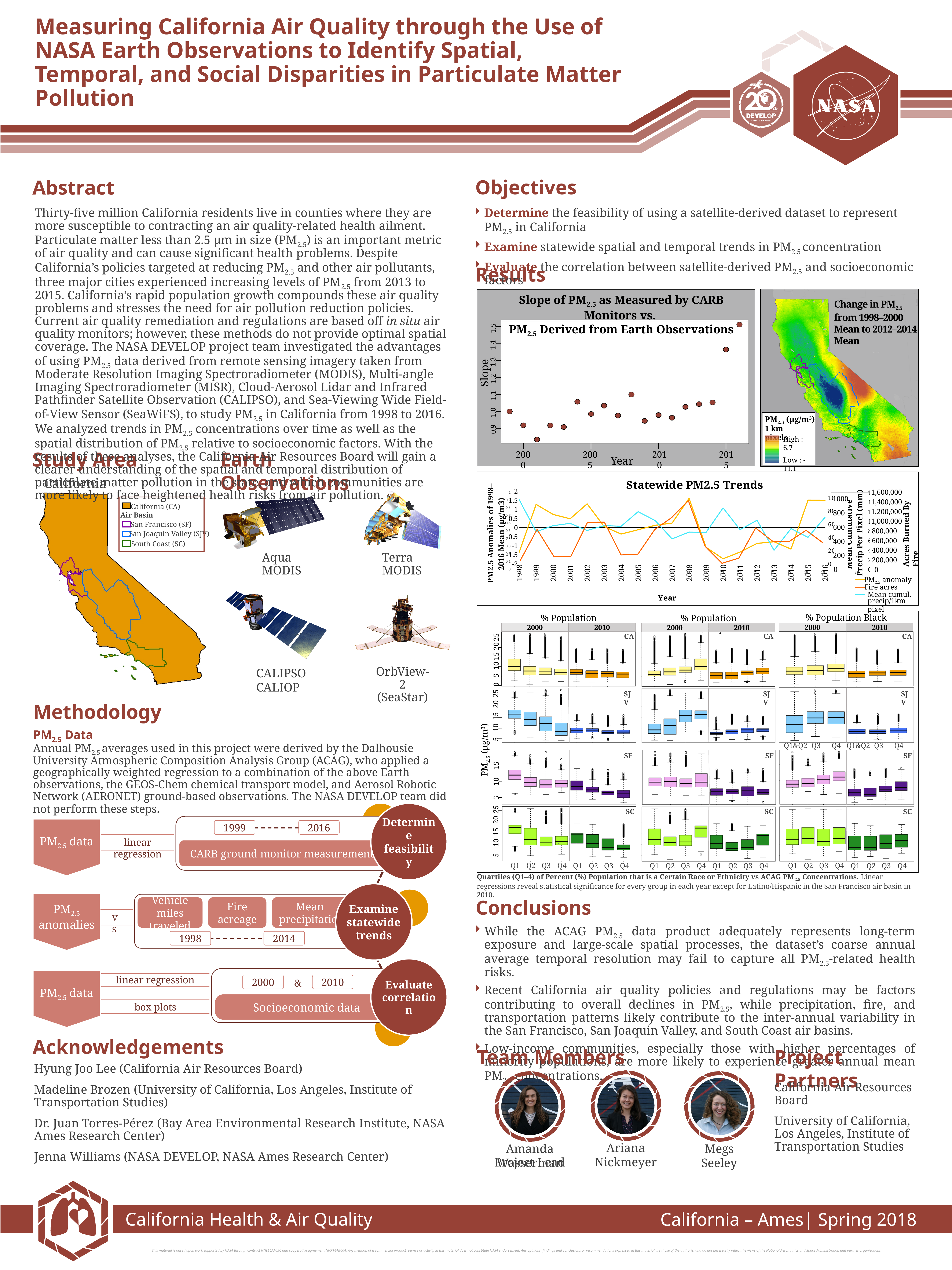
How many quartile groups (Q1–Q4) are shown along the x axis of each panel in the "% Population" box plot chart? 4 In the "Slope of PM2.5 as Measured by CARB Monitors vs. PM2.5 Derived from Earth Observations" chart, which year has the highest slope? 2016 In the "Statewide PM2.5 Trends" chart, which series is drawn in orange? Fire acres How many years are shown along the x axis of the "Statewide PM2.5 Trends" chart? 19 What is the y-axis label of the "Slope of PM2.5 as Measured by CARB Monitors vs. PM2.5 Derived from Earth Observations" chart? Slope What kind of chart is the "Statewide PM2.5 Trends" chart? line chart How many series does the legend of the "Statewide PM2.5 Trends" chart list? 3 In the "Slope of PM2.5 as Measured by CARB Monitors vs. PM2.5 Derived from Earth Observations" chart, do the slope values overall rise or fall from 2000 to 2016? rise In the "Slope of PM2.5 as Measured by CARB Monitors vs. PM2.5 Derived from Earth Observations" chart, is the slope value for the last point (2016) greater or less than 1.4? greater What kind of chart is the "% Population" chart at the lower right of the poster? box plot In the "Slope of PM2.5 as Measured by CARB Monitors vs. PM2.5 Derived from Earth Observations" chart, is the slope value for 2000 greater or less than 1.1? less What kind of chart is the "Slope of PM2.5 as Measured by CARB Monitors vs. PM2.5 Derived from Earth Observations" chart? scatter plot